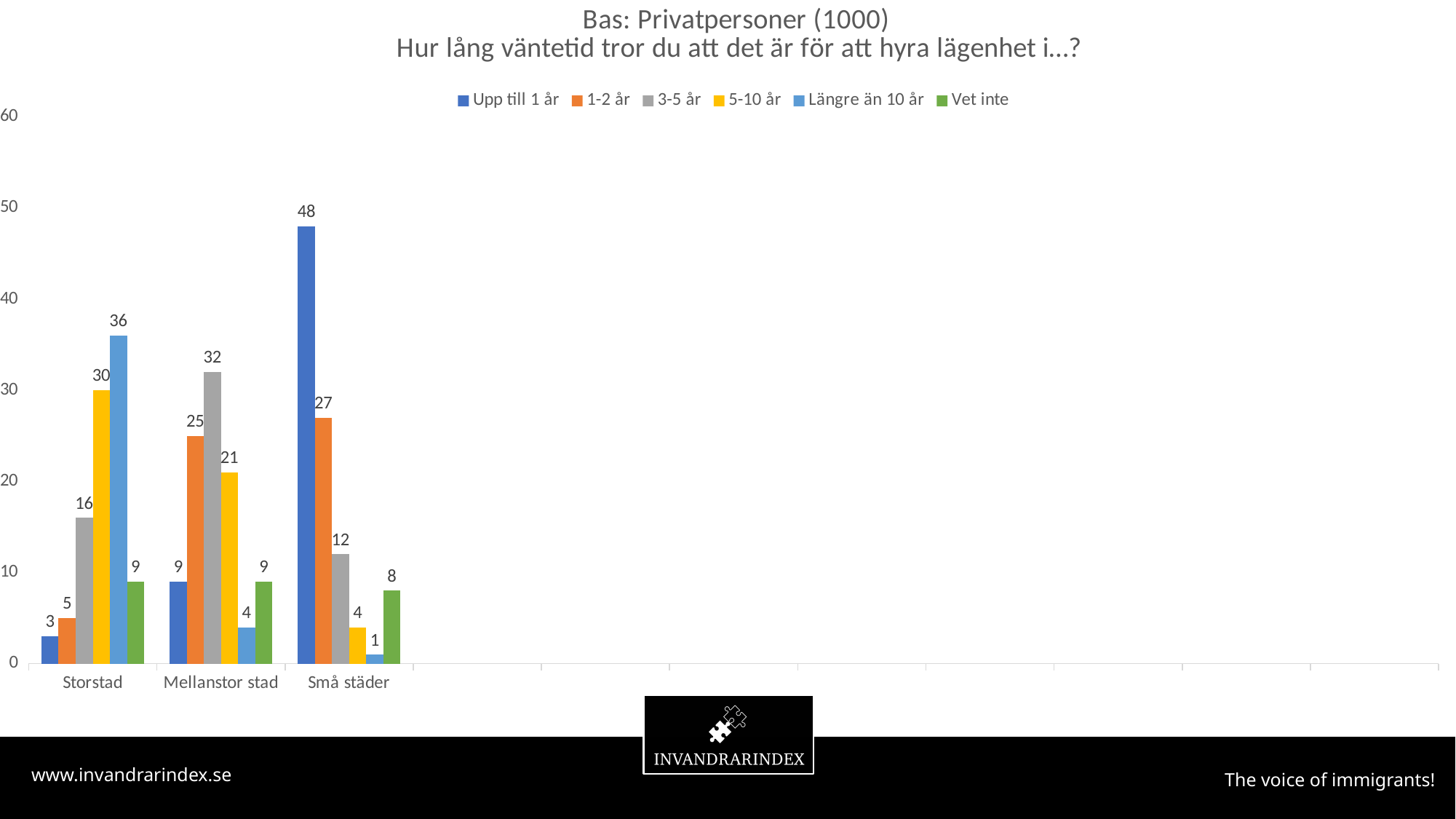
How many series does the legend list? 6 Which series has the lowest value in the Små städer category? Längre än 10 år How many categories are shown on the x axis? 3 What is the value for "Upp till 1 år" in the Små städer category? 48 Which series has the highest value in the Mellanstor stad category? 3-5 år How does the "Upp till 1 år" value change from Storstad to Små städer? It rises Is the value for "Upp till 1 år" in Små städer greater or less than 40? greater What kind of chart is shown on the slide? bar chart Which is larger: the "1-2 år" value for Mellanstor stad or for Små städer? Små städer What is the value for "Längre än 10 år" in the Storstad category? 36 What is the value for "3-5 år" in the Mellanstor stad category? 32 What is the difference between the "5-10 år" values for Storstad and Mellanstor stad? 9